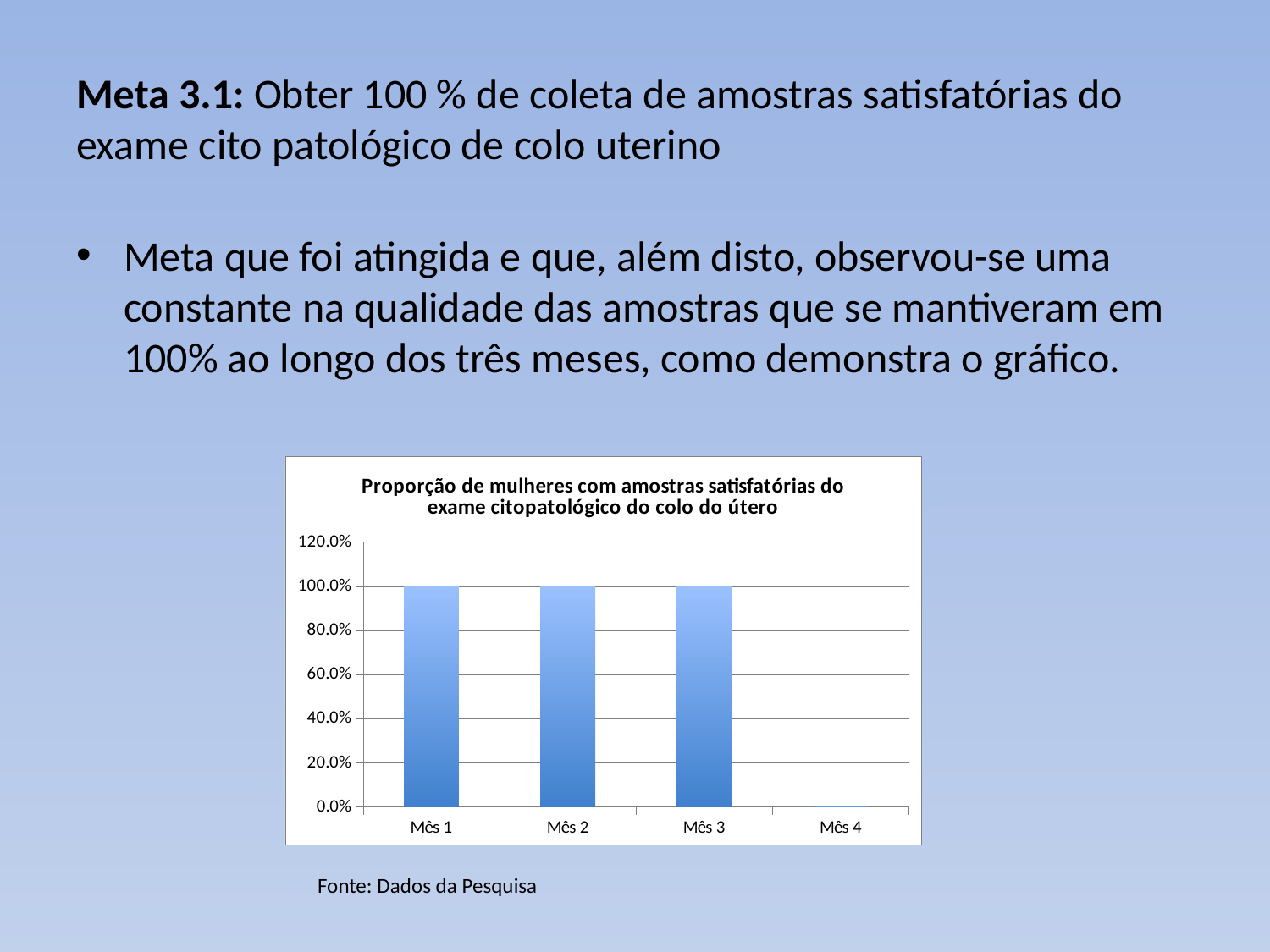
What is the highest value shown on the y axis? 120.0% What is the title of the chart? Proporção de mulheres com amostras satisfatórias do exame citopatológico do colo do útero Is there a bar plotted for Mês 4? No What is the value for Mês 2? 100.0% How many bars are plotted in the chart? 3 What is the value for Mês 1? 100.0% Is the value for Mês 2 greater or less than 80.0%? greater What is the value for Mês 3? 100.0% What kind of chart is shown on the slide? bar chart Do the values rise, fall or stay the same from Mês 1 to Mês 3? stay the same What is the difference between the values for Mês 1 and Mês 3? 0.0% How many categories are shown on the x axis? 4